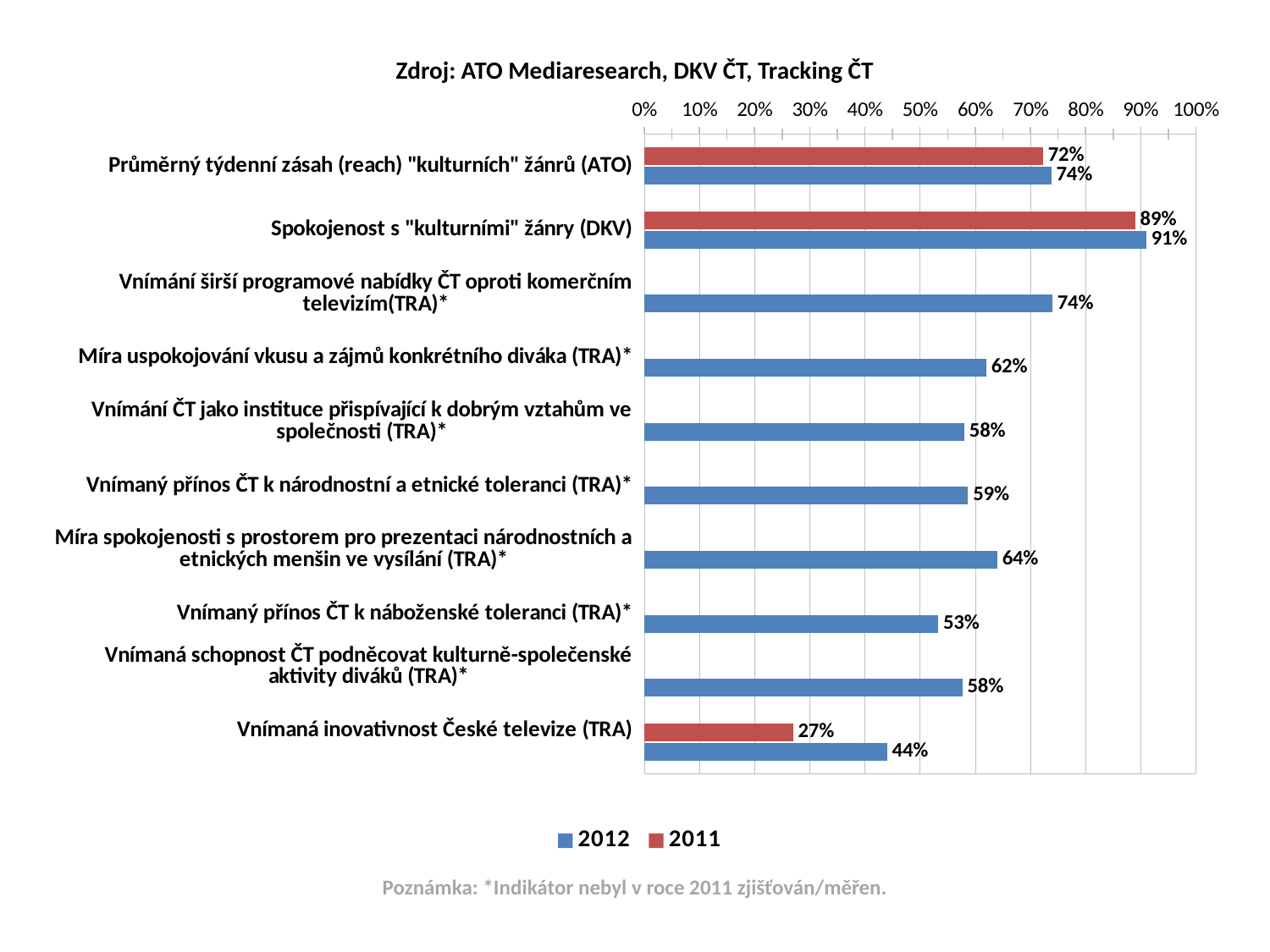
How many categories are shown on the chart? 10 Which category has the lowest 2012 value? Vnímaná inovativnost České televize (TRA) What is the difference between the 2012 and 2011 values for "Spokojenost s "kulturními" žánry (DKV)"? 2% What is the difference between the 2012 and 2011 values for "Vnímaná inovativnost České televize (TRA)"? 17% Which colour represents the 2011 series? Red What is the 2012 value for "Vnímaný přínos ČT k náboženské toleranci (TRA)*"? 53% Which category has the highest 2012 value? Spokojenost s "kulturními" žánry (DKV) What kind of chart is shown on the slide? Bar chart What is the 2012 value for "Spokojenost s "kulturními" žánry (DKV)"? 91% Which is larger for "Průměrný týdenní zásah (reach) "kulturních" žánrů (ATO)": the 2012 value or the 2011 value? 2012 What is the 2011 value for "Vnímaná inovativnost České televize (TRA)"? 27% How many series does the legend list? 2